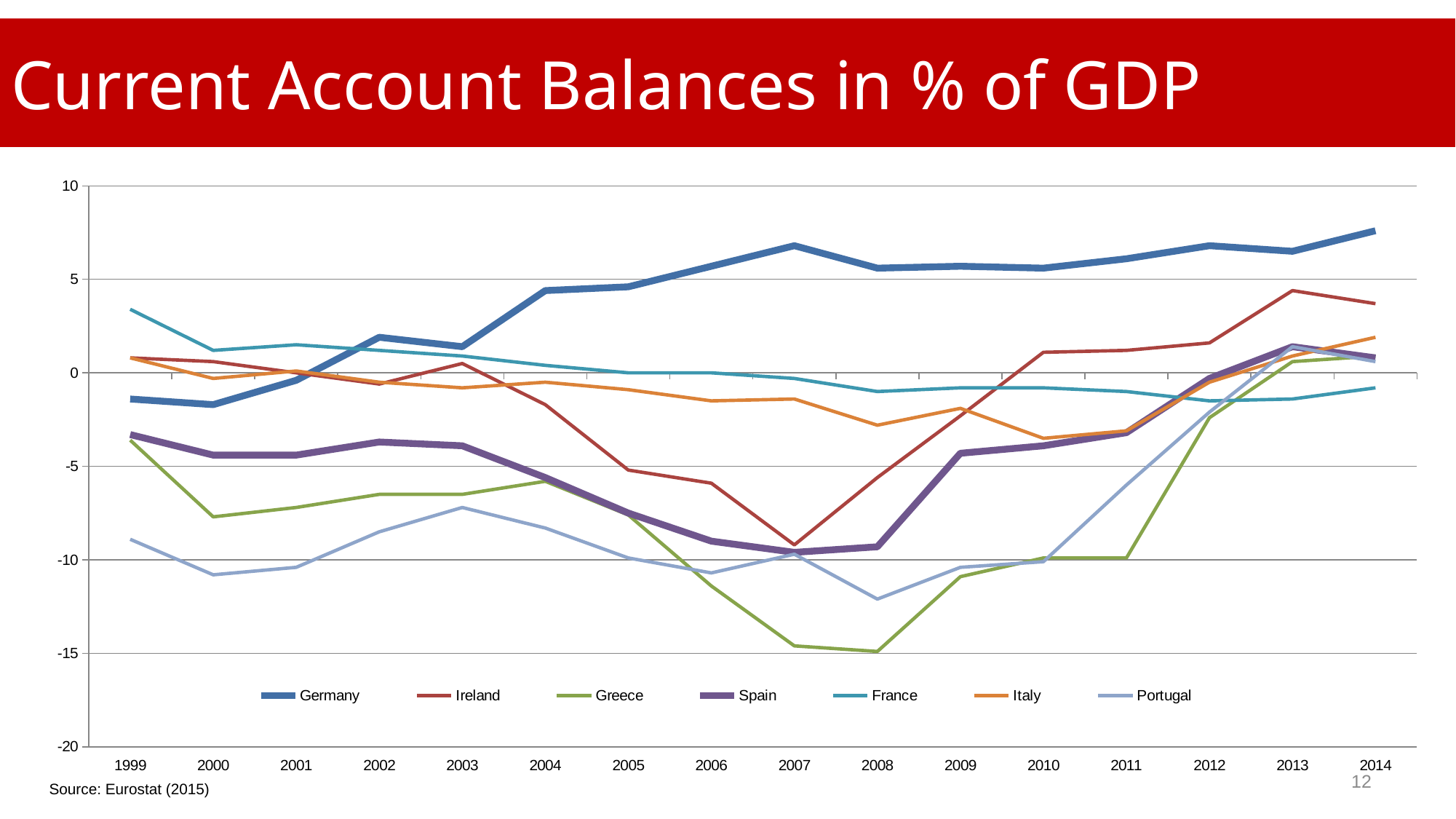
Is the value for Greece in 2007 greater or less than -10? less What is the title of the slide? Current Account Balances in % of GDP Which country has the lowest current account balance in 2008? Greece Which country has the highest current account balance in 2014? Germany Does the Germany line rise or fall between 2001 and 2007? rise How many years are shown along the x axis? 16 How many countries does the legend list? 7 What kind of chart is shown on the slide? line chart In 2010, which is larger: the value for Ireland or the value for Italy? Ireland Which country has the lowest current account balance in 1999? Portugal Is the value for Portugal in 2008 greater or less than -10? less Is the value for Germany in 2007 greater or less than 5? greater